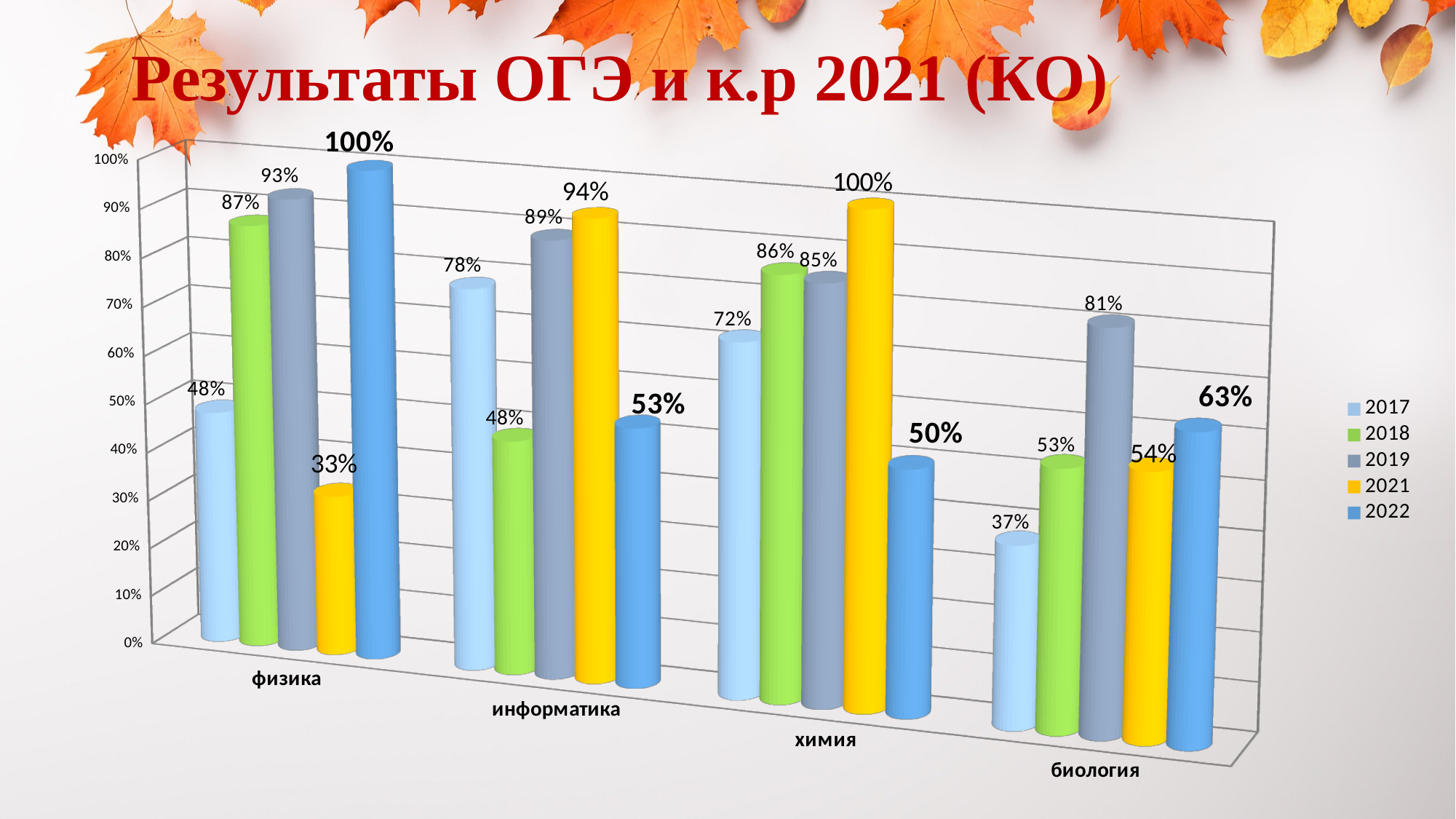
Which category has the lowest value in the 2021 series? физика What kind of chart is shown on the slide? bar chart Which is larger: the 2018 value for химия or the 2018 value for информатика? химия What is the value for биология in the 2017 series? 37% What is the value for физика in the 2022 series? 100% What is the difference between the 2022 values for физика and биология? 37% How many categories are shown on the x axis? 4 How many series does the legend list? 5 What is the value for химия in the 2019 series? 85% What is the title of the slide? Результаты ОГЭ и к.р 2021 (КО) What is the value for информатика in the 2021 series? 94% Which category has the highest value in the 2019 series? физика